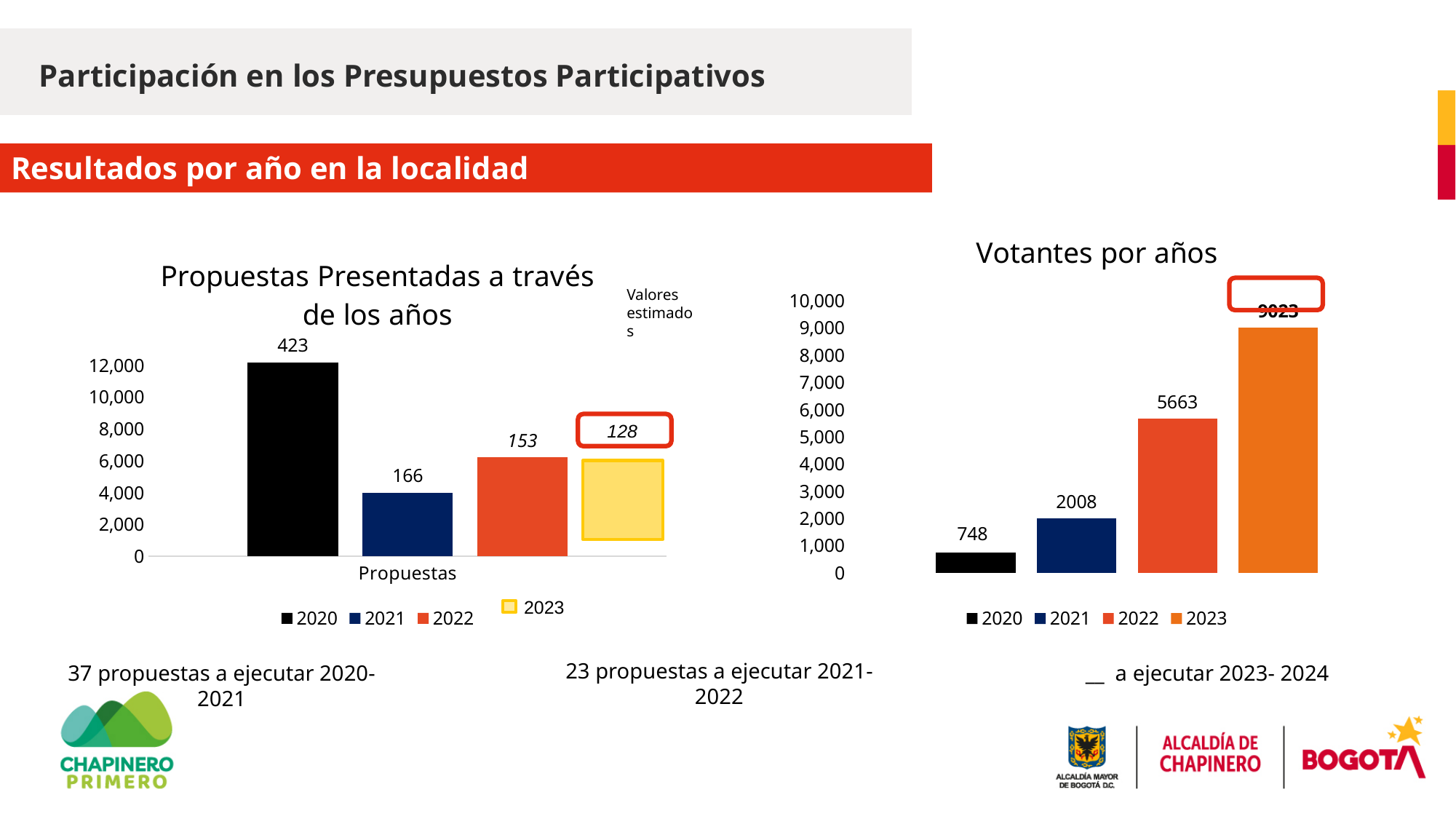
In the 'Propuestas Presentadas a través de los años' chart, what is the value for 2023? 128 What kind of chart is the 'Propuestas Presentadas a través de los años' chart? bar chart In the 'Votantes por años' chart, do the values rise or fall from 2020 to 2023? rise In the 'Propuestas Presentadas a través de los años' chart, what is the value for 2020? 423 In the 'Votantes por años' chart, what is the value for 2022? 5663 In the 'Votantes por años' chart, which year has the highest value? 2023 In the 'Propuestas Presentadas a través de los años' chart, what is the difference between the 2020 and 2021 values? 257 How many series does the legend of the 'Propuestas Presentadas a través de los años' chart list? 4 In the 'Propuestas Presentadas a través de los años' chart, what is the value for 2021? 166 In the 'Votantes por años' chart, what is the value for 2020? 748 In the 'Votantes por años' chart, is the value for 2023 greater or less than 8,000? greater In the 'Propuestas Presentadas a través de los años' chart, which year has the highest value? 2020